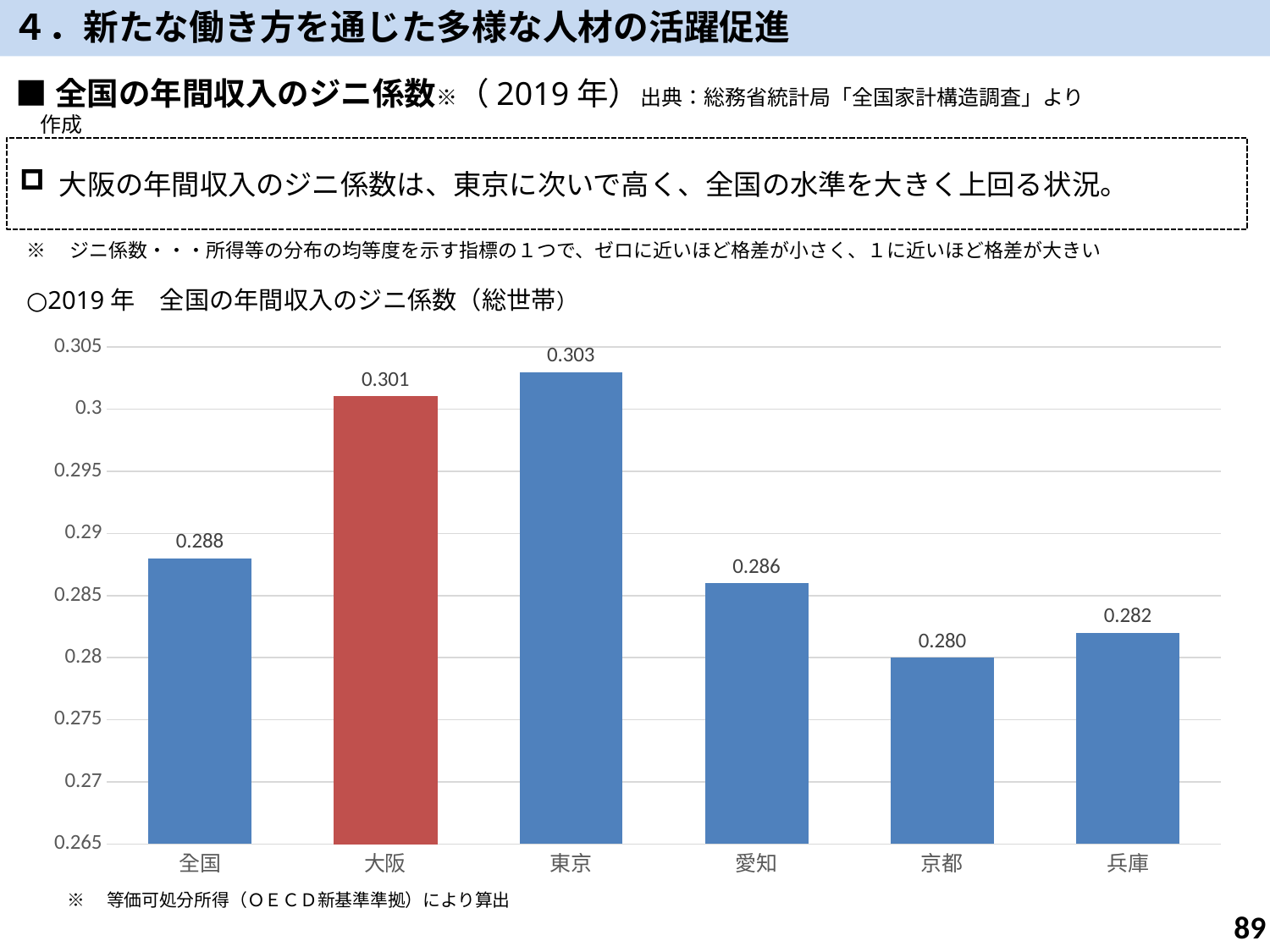
Which bar is coloured red instead of blue? 大阪 What is the Gini coefficient value shown for 大阪? 0.301 How many categories are shown on the x axis? 6 What is the Gini coefficient value shown for 全国? 0.288 What kind of chart is shown on the slide? bar chart Which is larger, the value for 愛知 or the value for 兵庫? 愛知 What is the value shown for 京都? 0.280 Which category has the highest Gini coefficient? 東京 Which category has the lowest Gini coefficient? 京都 Is the value for 東京 greater or less than 0.3? greater What is the difference between the values for 東京 and 大阪? 0.002 What is the difference between the values for 大阪 and 全国? 0.013